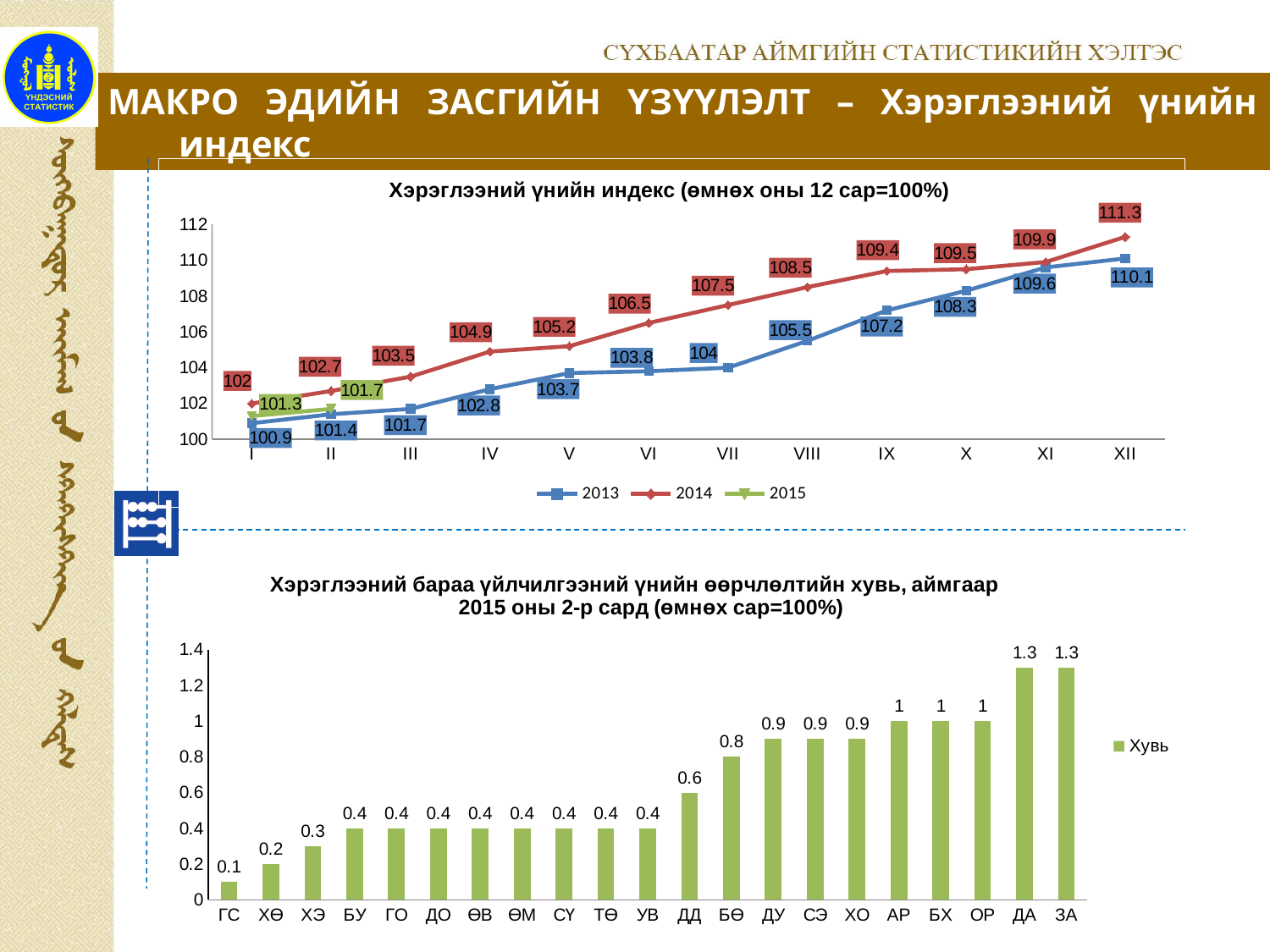
In the bottom chart (Хэрэглээний бараа үйлчилгээний үнийн өөрчлөлтийн хувь, аймгаар), how many categories are shown on the x axis? 21 What kind of chart is the bottom chart (Хэрэглээний бараа үйлчилгээний үнийн өөрчлөлтийн хувь, аймгаар)? bar chart In the top chart (Хэрэглээний үнийн индекс), what is the value for 2013 in month VIII? 105.5 In the top chart (Хэрэглээний үнийн индекс), what is the value for 2014 in month XII? 111.3 In the top chart (Хэрэглээний үнийн индекс), how many series does the legend list? 3 In the bottom chart (Хэрэглээний бараа үйлчилгээний үнийн өөрчлөлтийн хувь, аймгаар), which category has the lowest value? ГС In the bottom chart (Хэрэглээний бараа үйлчилгээний үнийн өөрчлөлтийн хувь, аймгаар), what is the value for ДД? 0.6 In the top chart (Хэрэглээний үнийн индекс), do the 2013 values rise or fall from month I to month XII? rise In the bottom chart (Хэрэглээний бараа үйлчилгээний үнийн өөрчлөлтийн хувь, аймгаар), what is the difference between the values for ЗА and БӨ? 0.5 In the top chart (Хэрэглээний үнийн индекс), which is larger in month IV: the 2013 value or the 2014 value? 2014 In the top chart (Хэрэглээний үнийн индекс), what is the difference between the 2014 and 2013 values in month XII? 1.2 In the top chart (Хэрэглээний үнийн индекс), what is the value for 2015 in month II? 101.7